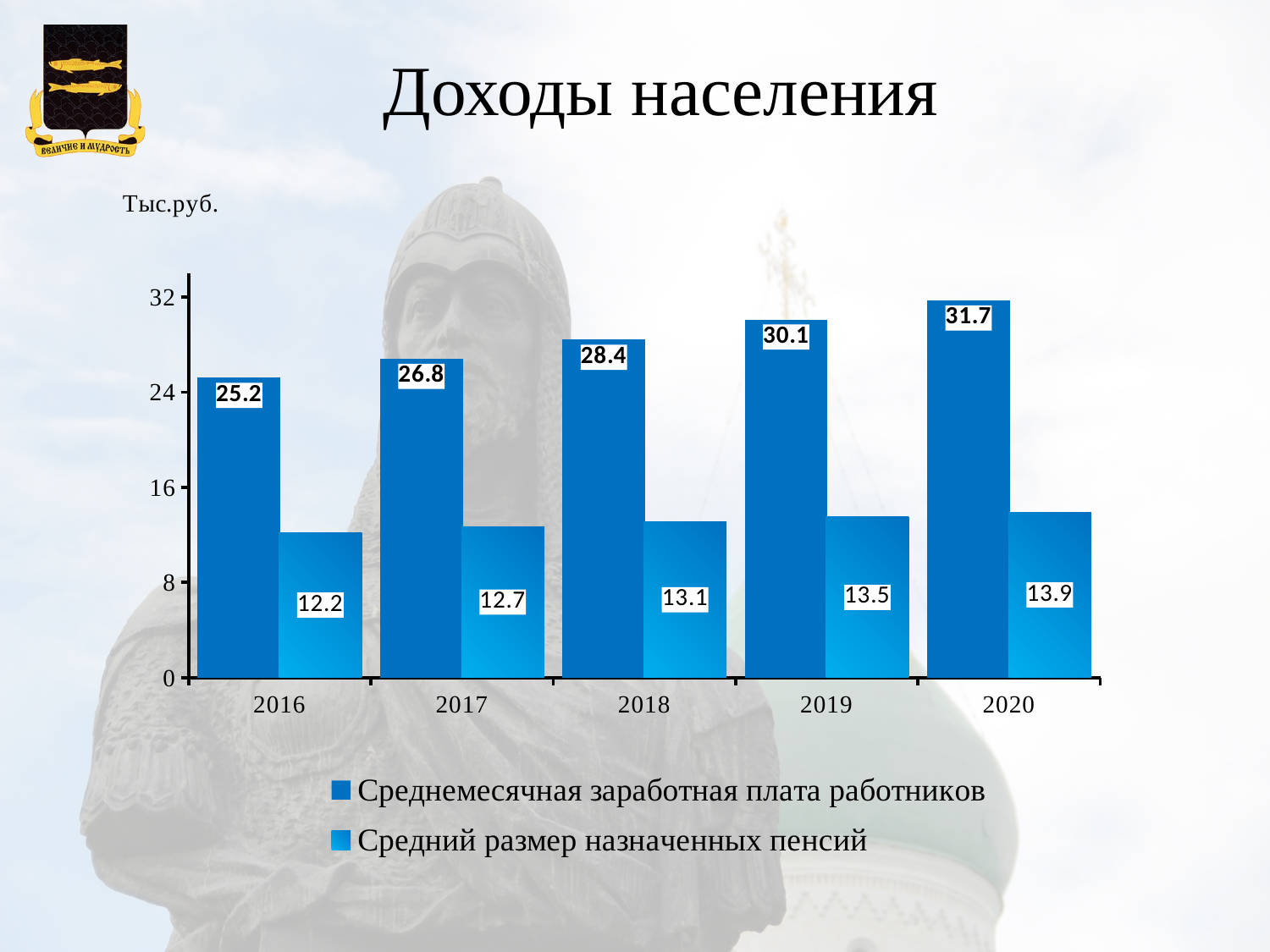
How many series does the legend list? 2 What was the average monthly salary of workers (Среднемесячная заработная плата работников) in 2018? 28.4 In which year was the average monthly salary of workers highest? 2020 Which is larger: the average pension in 2019 or the average pension in 2017? 2019 How many years are shown on the x axis of the chart? 5 What kind of chart is shown on the slide? bar chart In which year was the average size of assigned pensions lowest? 2016 Does the average size of assigned pensions rise or fall from 2016 to 2020? rise What is the difference between the average monthly salary of workers and the average pension in 2020? 17.8 Is the average monthly salary of workers in 2019 greater or less than 24? greater What was the average size of assigned pensions (Средний размер назначенных пенсий) in 2016? 12.2 By how much did the average monthly salary of workers increase from 2016 to 2020? 6.5